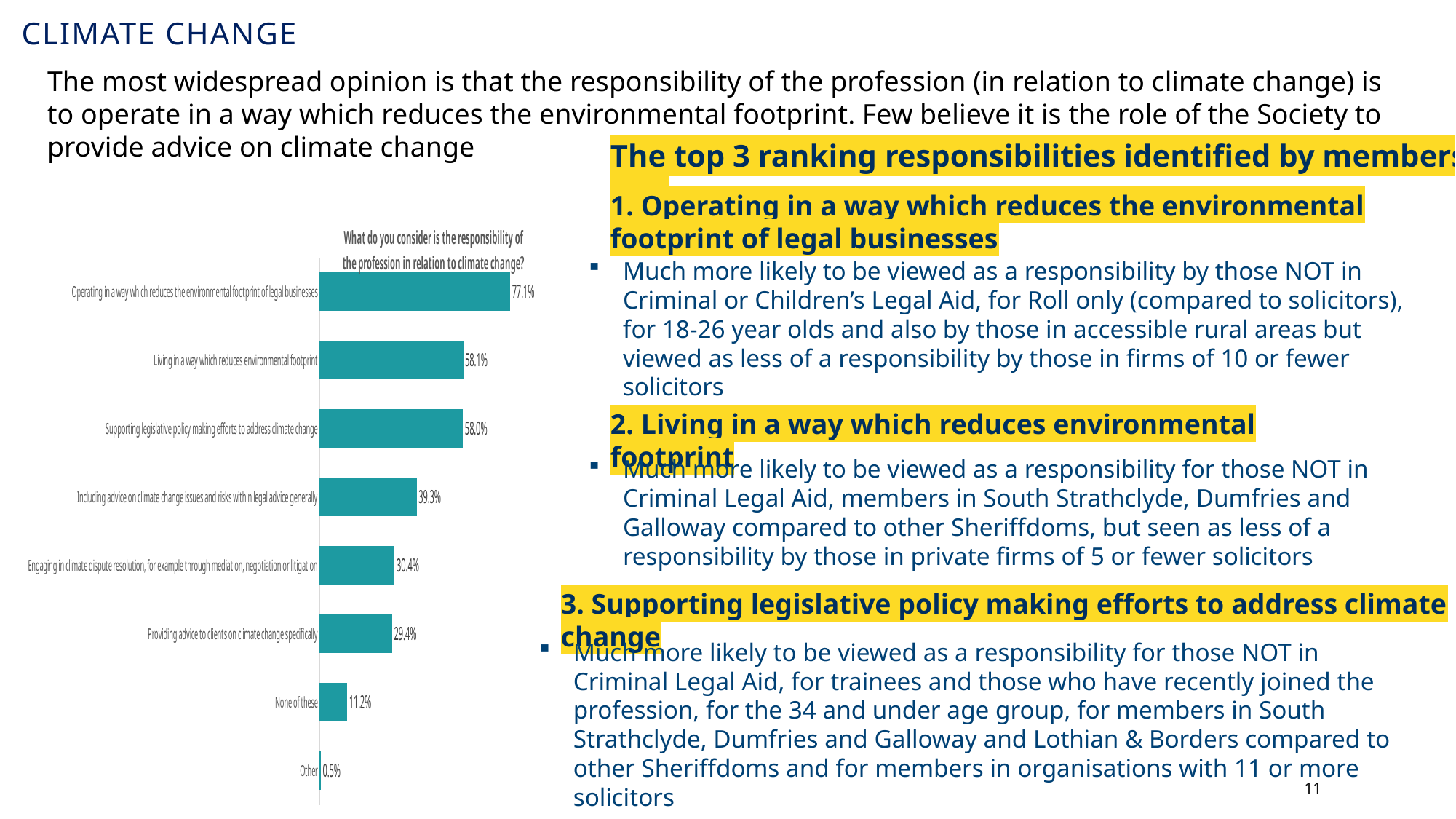
What percentage of respondents consider 'Operating in a way which reduces the environmental footprint of legal businesses' a responsibility of the profession? 77.1% How many categories are shown in the chart? 8 Which category has the lowest value in the chart? Other What is the difference between the values for 'Operating in a way which reduces the environmental footprint of legal businesses' and 'Living in a way which reduces environmental footprint'? 19.0% What is the difference between the values for 'Including advice on climate change issues and risks within legal advice generally' and 'None of these'? 28.1% What kind of chart is shown on the slide? Bar chart What is the value shown for 'Providing advice to clients on climate change specifically'? 29.4% What is the value shown for 'Including advice on climate change issues and risks within legal advice generally'? 39.3% Which is larger: the value for 'Engaging in climate dispute resolution, for example through mediation, negotiation or litigation' or the value for 'Providing advice to clients on climate change specifically'? Engaging in climate dispute resolution, for example through mediation, negotiation or litigation Which category has the highest value in the chart? Operating in a way which reduces the environmental footprint of legal businesses What is the title of the chart? What do you consider is the responsibility of the profession in relation to climate change? What is the value shown for 'None of these'? 11.2%